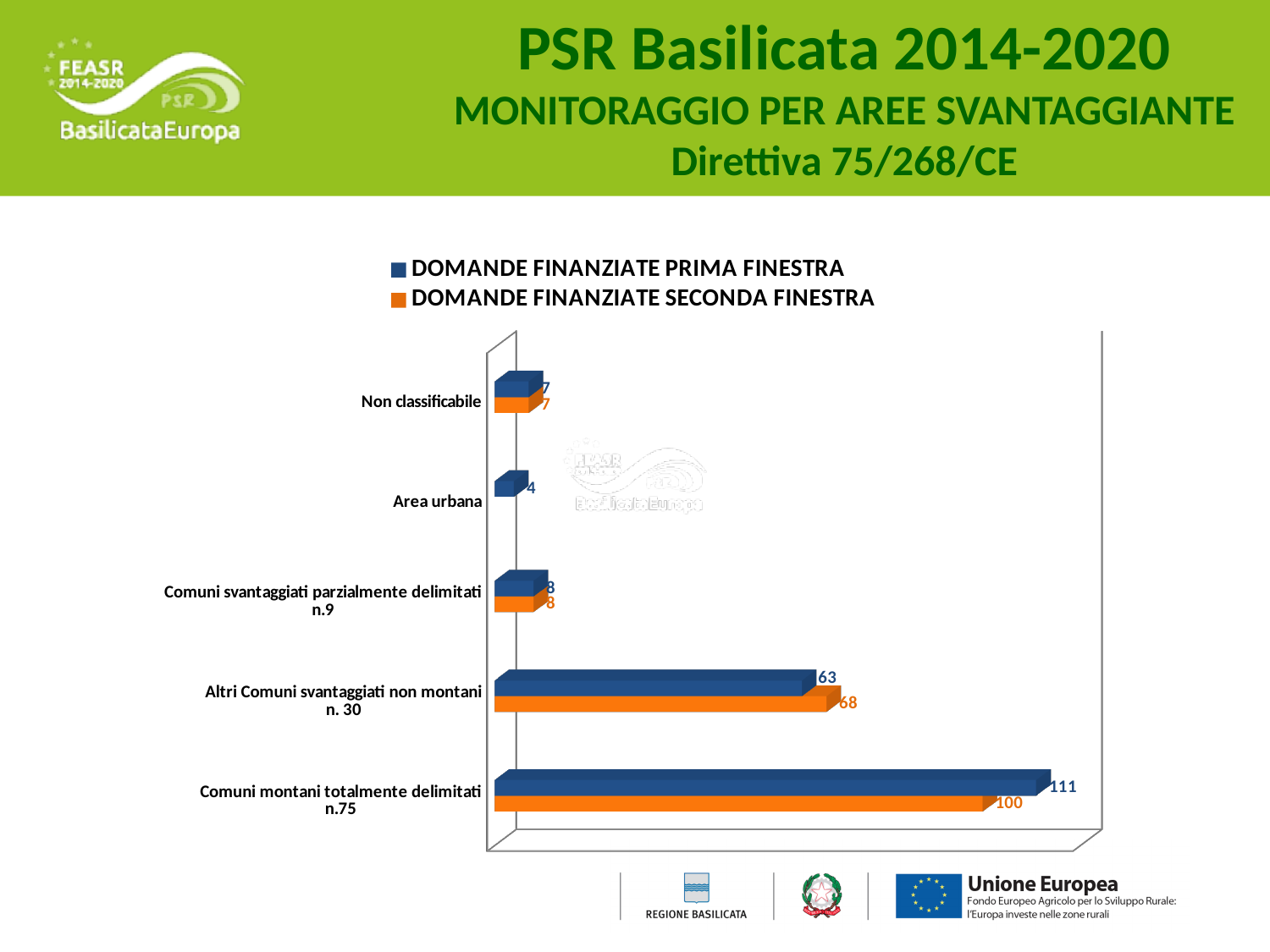
What is the difference between DOMANDE FINANZIATE PRIMA FINESTRA and DOMANDE FINANZIATE SECONDA FINESTRA for Comuni montani totalmente delimitati n.75? 11 How many series does the legend list? 2 What is the value of DOMANDE FINANZIATE PRIMA FINESTRA for Comuni montani totalmente delimitati n.75? 111 What kind of chart is shown on the slide? bar chart What is the value of DOMANDE FINANZIATE PRIMA FINESTRA for Area urbana? 4 Which colour represents DOMANDE FINANZIATE SECONDA FINESTRA in the legend? orange Which category has the lowest value for DOMANDE FINANZIATE PRIMA FINESTRA? Area urbana How many categories are shown on the chart? 5 Which category has the highest value for DOMANDE FINANZIATE PRIMA FINESTRA? Comuni montani totalmente delimitati n.75 What is the value of DOMANDE FINANZIATE SECONDA FINESTRA for Comuni montani totalmente delimitati n.75? 100 What is the value of DOMANDE FINANZIATE SECONDA FINESTRA for Altri Comuni svantaggiati non montani n. 30? 68 For Altri Comuni svantaggiati non montani n. 30, which series has the larger value, DOMANDE FINANZIATE PRIMA FINESTRA or DOMANDE FINANZIATE SECONDA FINESTRA? DOMANDE FINANZIATE SECONDA FINESTRA